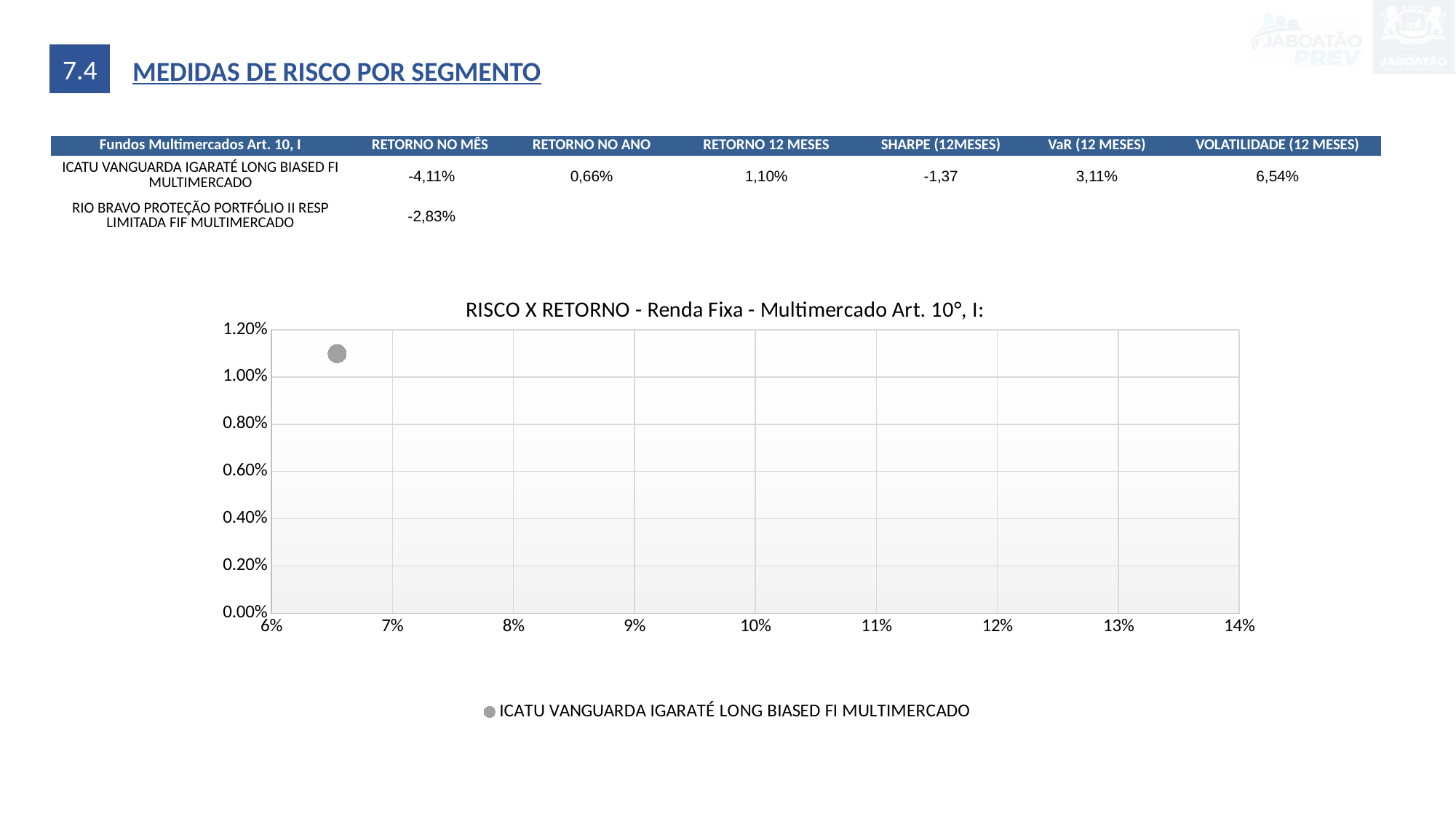
On the RISCO X RETORNO chart, is the horizontal (risk) value of the ICATU VANGUARDA IGARATÉ LONG BIASED FI MULTIMERCADO point greater or less than 6%? greater What is the title of the chart on the slide? RISCO X RETORNO - Renda Fixa - Multimercado Art. 10°, I: On the RISCO X RETORNO chart, is the horizontal (risk) value of the ICATU VANGUARDA IGARATÉ LONG BIASED FI MULTIMERCADO point greater or less than 7%? less On the RISCO X RETORNO chart, is the vertical (return) value of the plotted point greater or less than 0.80%? greater Which fund is listed in the legend of the RISCO X RETORNO chart? ICATU VANGUARDA IGARATÉ LONG BIASED FI MULTIMERCADO How many data points are plotted on the RISCO X RETORNO chart? 1 How many series does the legend of the RISCO X RETORNO chart list? 1 What kind of chart is shown under the title "RISCO X RETORNO - Renda Fixa - Multimercado Art. 10°, I:"? Scatter chart